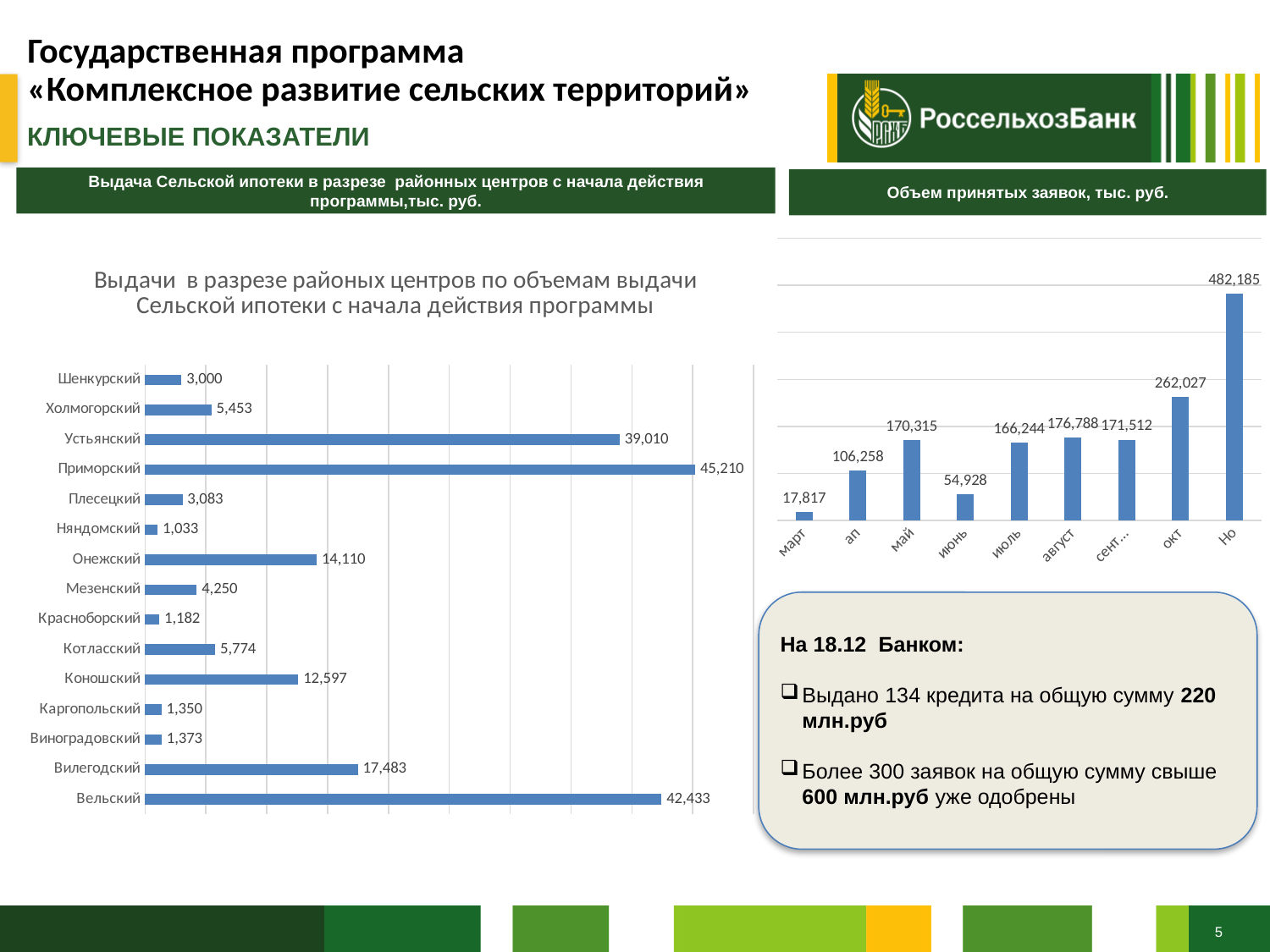
On the left chart (Выдачи в разрезе районых центров), how many districts are shown? 15 On the left chart (Выдачи в разрезе районых центров), what type of chart is it? Bar chart On the left chart (Выдачи в разрезе районых центров), what is the value for Онежский? 14,110 On the right chart (Объем принятых заявок, тыс. руб.), which is larger: май or июль? май On the left chart (Выдачи в разрезе районых центров), which district has the highest value? Приморский On the left chart (Выдачи в разрезе районых центров), what is the difference between Вельский and Вилегодский? 24,950 On the right chart (Объем принятых заявок, тыс. руб.), which month has the lowest value? март On the right chart (Объем принятых заявок, тыс. руб.), what is the value for окт? 262,027 On the right chart (Объем принятых заявок, тыс. руб.), what is the value for июнь? 54,928 On the left chart (Выдачи в разрезе районых центров), which district has the lowest value? Няндомский On the left chart (Выдачи в разрезе районых центров), what is the value for Приморский? 45,210 On the right chart (Объем принятых заявок, тыс. руб.), how many months are plotted? 9